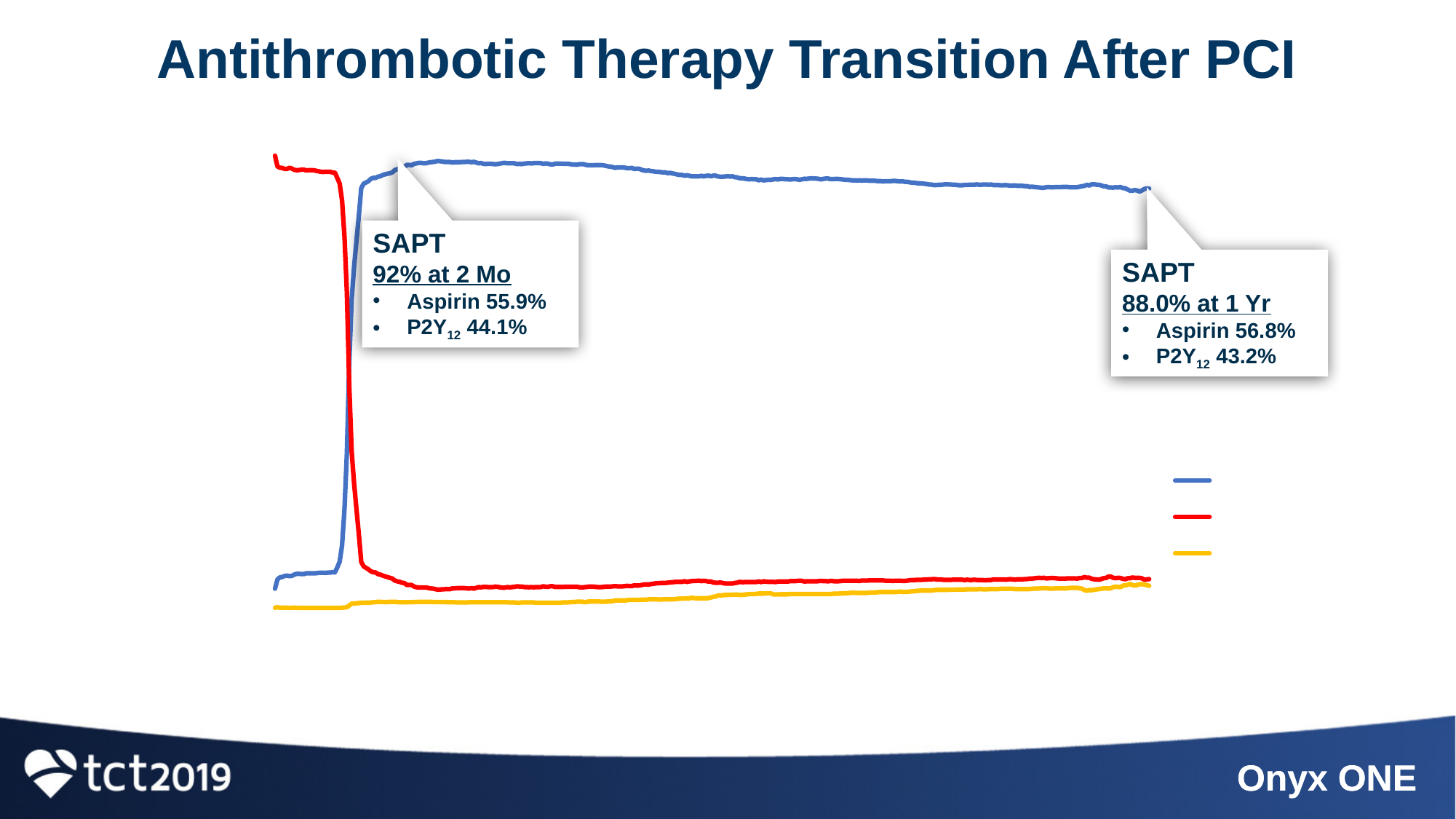
What is the SAPT value at 1 year according to the callout? 88.0% How many entries does the legend show? 3 Does the blue line rise or fall between the 2-month callout and the 1-year callout? Fall What is the Aspirin percentage at 1 year? 56.8% How many lines are plotted on the chart? 3 What is the title of the chart slide? Antithrombotic Therapy Transition After PCI At 1 year, which is larger: the Aspirin percentage or the P2Y12 percentage? Aspirin What kind of chart is shown on the slide? Line chart What is the Aspirin percentage at 2 months? 55.9% What is the P2Y12 percentage at 1 year? 43.2% What is the SAPT value at 2 months according to the callout? 92% What is the P2Y12 percentage at 2 months? 44.1%